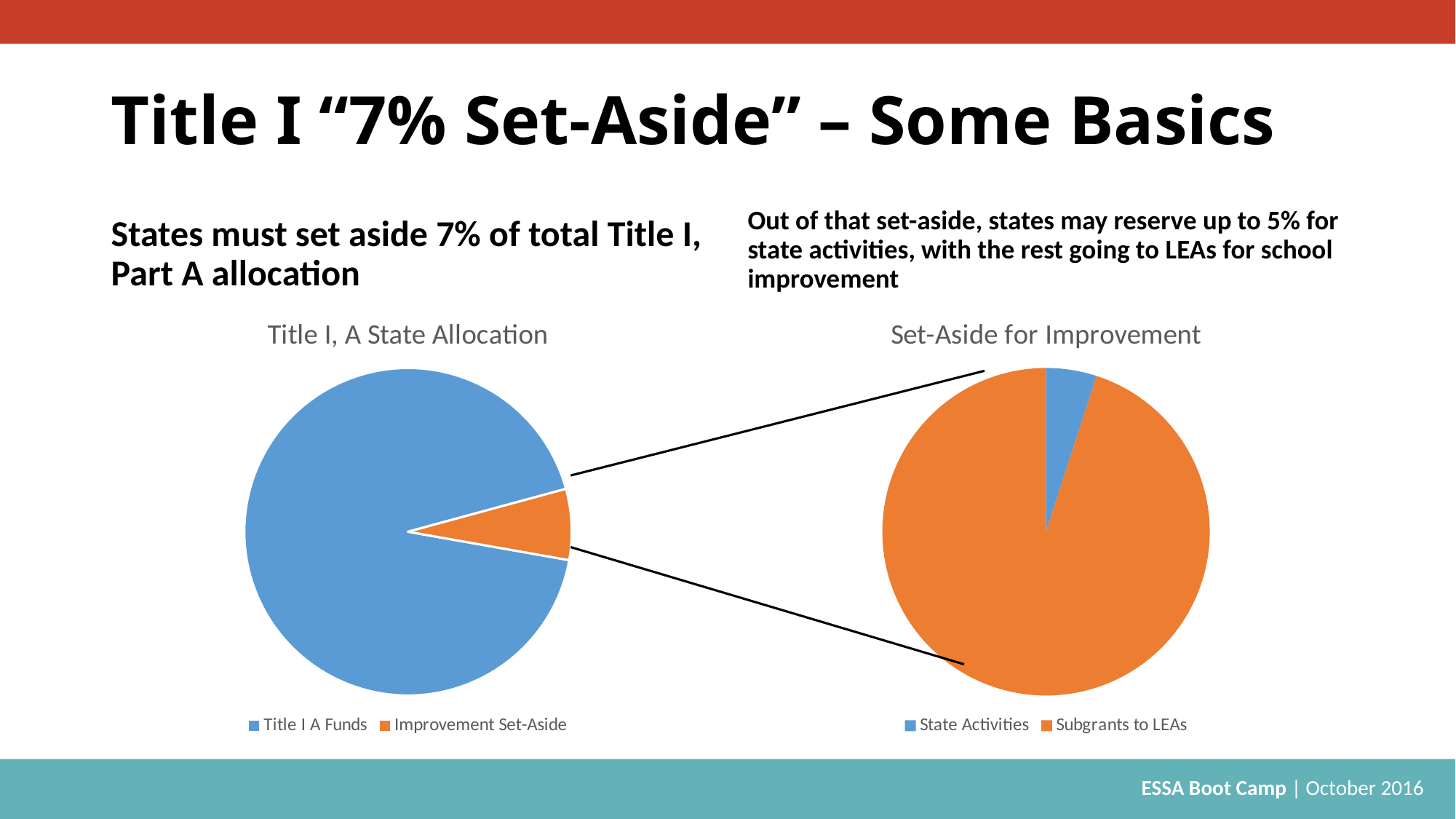
What kind of chart is "Set-Aside for Improvement"? pie chart In the "Set-Aside for Improvement" chart, what colour is the Subgrants to LEAs slice? orange In the "Set-Aside for Improvement" chart, which slice is the smallest? State Activities In the "Set-Aside for Improvement" chart, which slice is the largest? Subgrants to LEAs In the "Title I, A State Allocation" chart, which slice is the smallest? Improvement Set-Aside In the "Set-Aside for Improvement" chart, which is larger: State Activities or Subgrants to LEAs? Subgrants to LEAs In the "Title I, A State Allocation" chart, which slice is the largest? Title I A Funds How many slices does the "Title I, A State Allocation" pie chart have? 2 How many entries does the legend of the "Set-Aside for Improvement" chart list? 2 In the "Title I, A State Allocation" chart, which is larger: Title I A Funds or Improvement Set-Aside? Title I A Funds What is the title of the pie chart on the right side of the slide? Set-Aside for Improvement What kind of chart is "Title I, A State Allocation"? pie chart